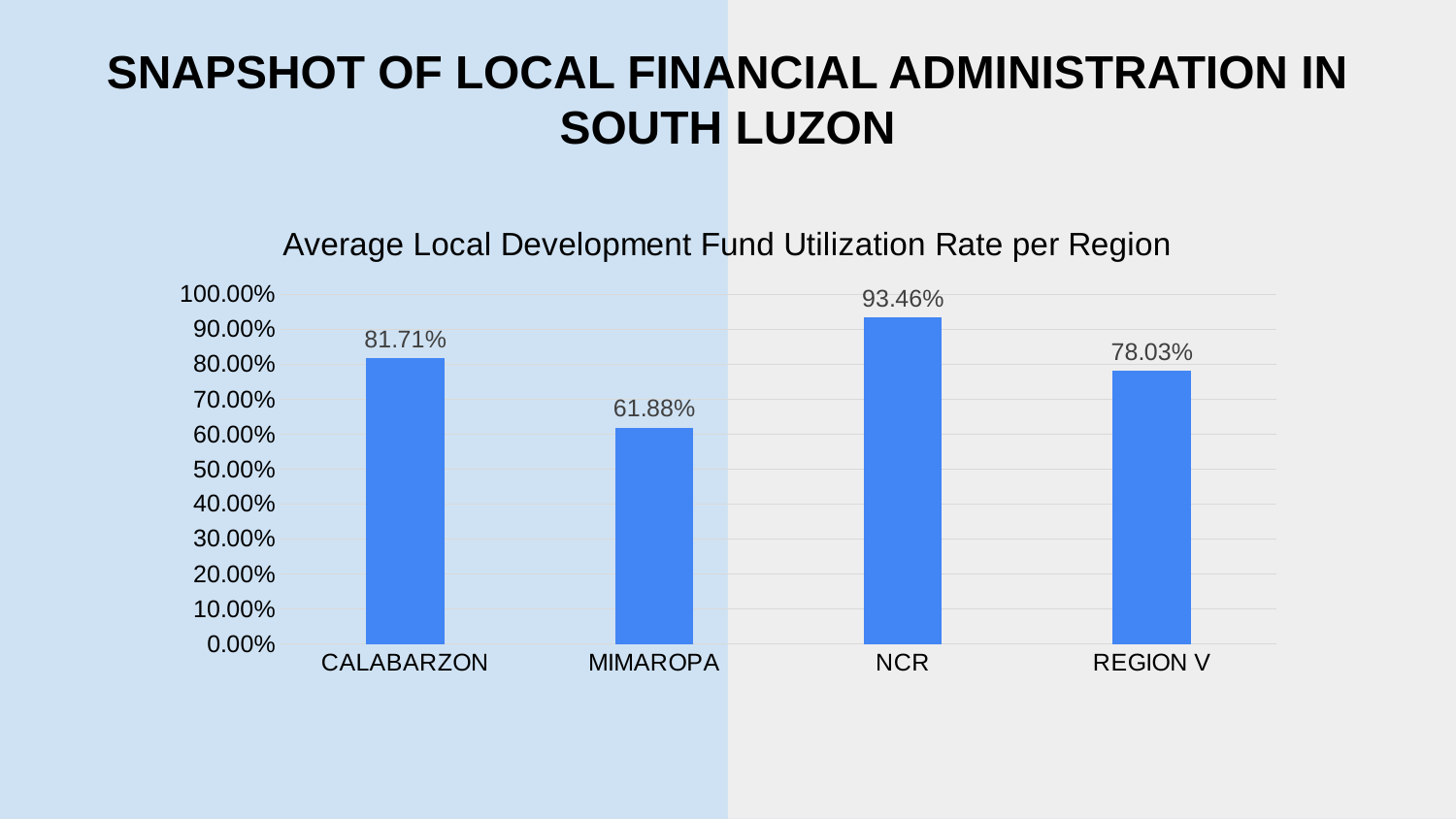
What is the difference between the values for NCR and MIMAROPA? 31.58% Is the value for MIMAROPA greater or less than 70.00%? less What kind of chart is used to show the utilization rates? Bar chart Which has a higher utilization rate, CALABARZON or REGION V? CALABARZON What is the value shown for MIMAROPA? 61.88% What is the value shown for NCR? 93.46% Which region has the lowest average Local Development Fund utilization rate? MIMAROPA How many regions are shown in the chart? 4 Which region has the highest average Local Development Fund utilization rate? NCR What is the difference between the values for CALABARZON and REGION V? 3.68% What is the value shown for REGION V? 78.03% What is the average Local Development Fund utilization rate for CALABARZON? 81.71%